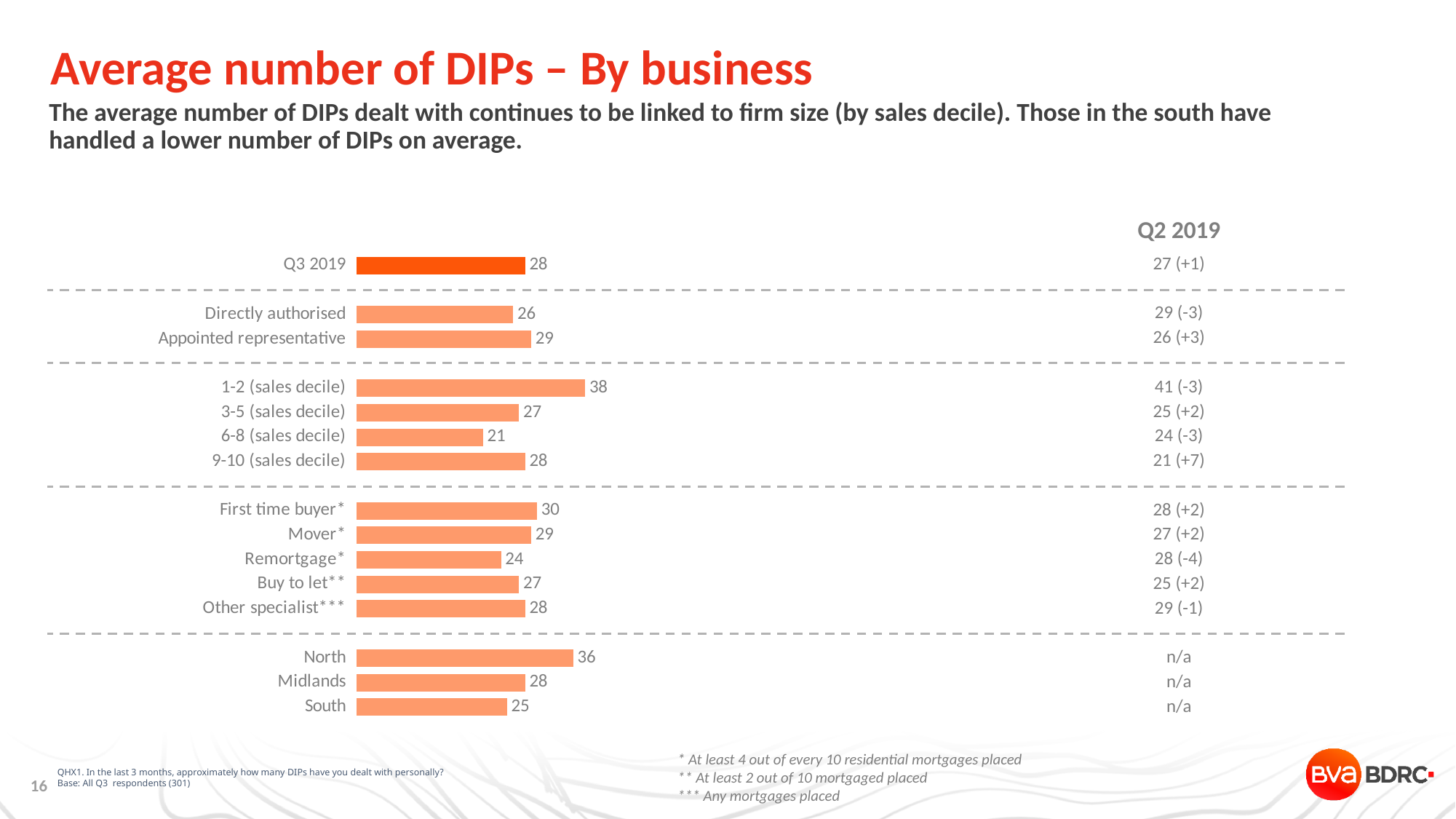
What is the average number of DIPs for Q3 2019 overall? 28 What is the value for the 1-2 (sales decile) category? 38 What is the difference between the values for North and South? 11 What kind of chart is shown on the slide? Bar chart What is the difference between the values for 1-2 (sales decile) and 6-8 (sales decile)? 17 Which is larger, the value for Directly authorised or Appointed representative? Appointed representative Which category has the highest value on the chart? 1-2 (sales decile) What was the Q2 2019 value shown for 9-10 (sales decile)? 21 (+7) Which is larger, the value for First time buyer or Mover? First time buyer Which category has the lowest value on the chart? 6-8 (sales decile) What is the value for South? 25 What is the value for Remortgage? 24